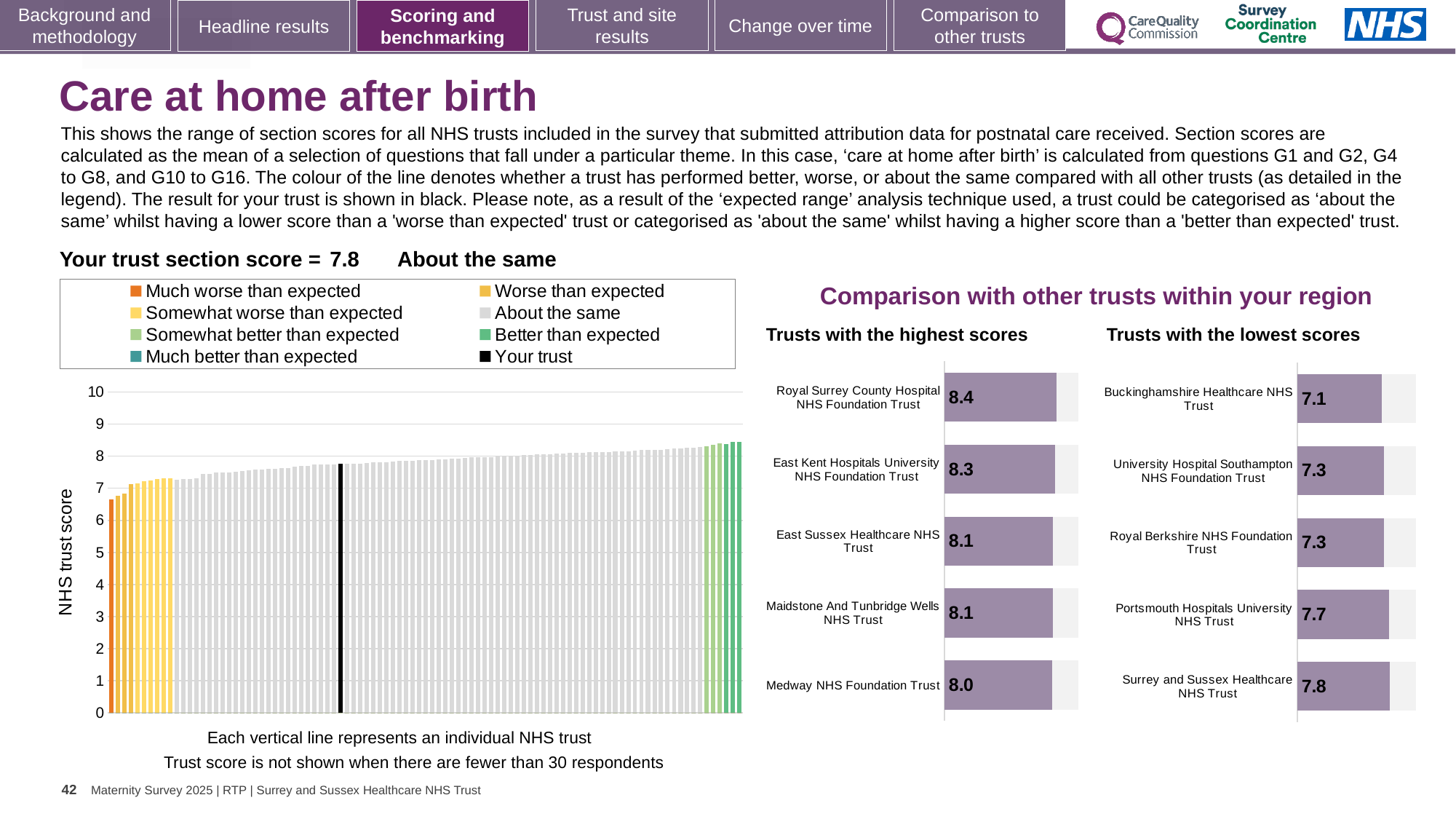
How many entries does the legend above the large chart on the left list? 8 In the 'Trusts with the highest scores' chart, what is the difference between the scores of Royal Surrey County Hospital NHS Foundation Trust and Medway NHS Foundation Trust? 0.4 In the large chart on the left, is the value of the leftmost bar greater or less than 6? greater In the large chart on the left, do the trust scores rise or fall from left to right? Rise In the 'Trusts with the highest scores' chart, what is the score for Royal Surrey County Hospital NHS Foundation Trust? 8.4 In the 'Trusts with the lowest scores' chart, which trust has the highest score? Surrey and Sussex Healthcare NHS Trust In the 'Trusts with the lowest scores' chart, which has the larger score: Portsmouth Hospitals University NHS Trust or Royal Berkshire NHS Foundation Trust? Portsmouth Hospitals University NHS Trust What type of chart is the large chart on the left with the y-axis labelled 'NHS trust score'? Bar chart In the 'Trusts with the lowest scores' chart, what is the score for Buckinghamshire Healthcare NHS Trust? 7.1 In the 'Trusts with the highest scores' chart, which trust has the lowest score shown? Medway NHS Foundation Trust In the 'Trusts with the lowest scores' chart, what is the difference between the scores of Surrey and Sussex Healthcare NHS Trust and Buckinghamshire Healthcare NHS Trust? 0.7 In the 'Trusts with the highest scores' chart, how many trusts are listed? 5